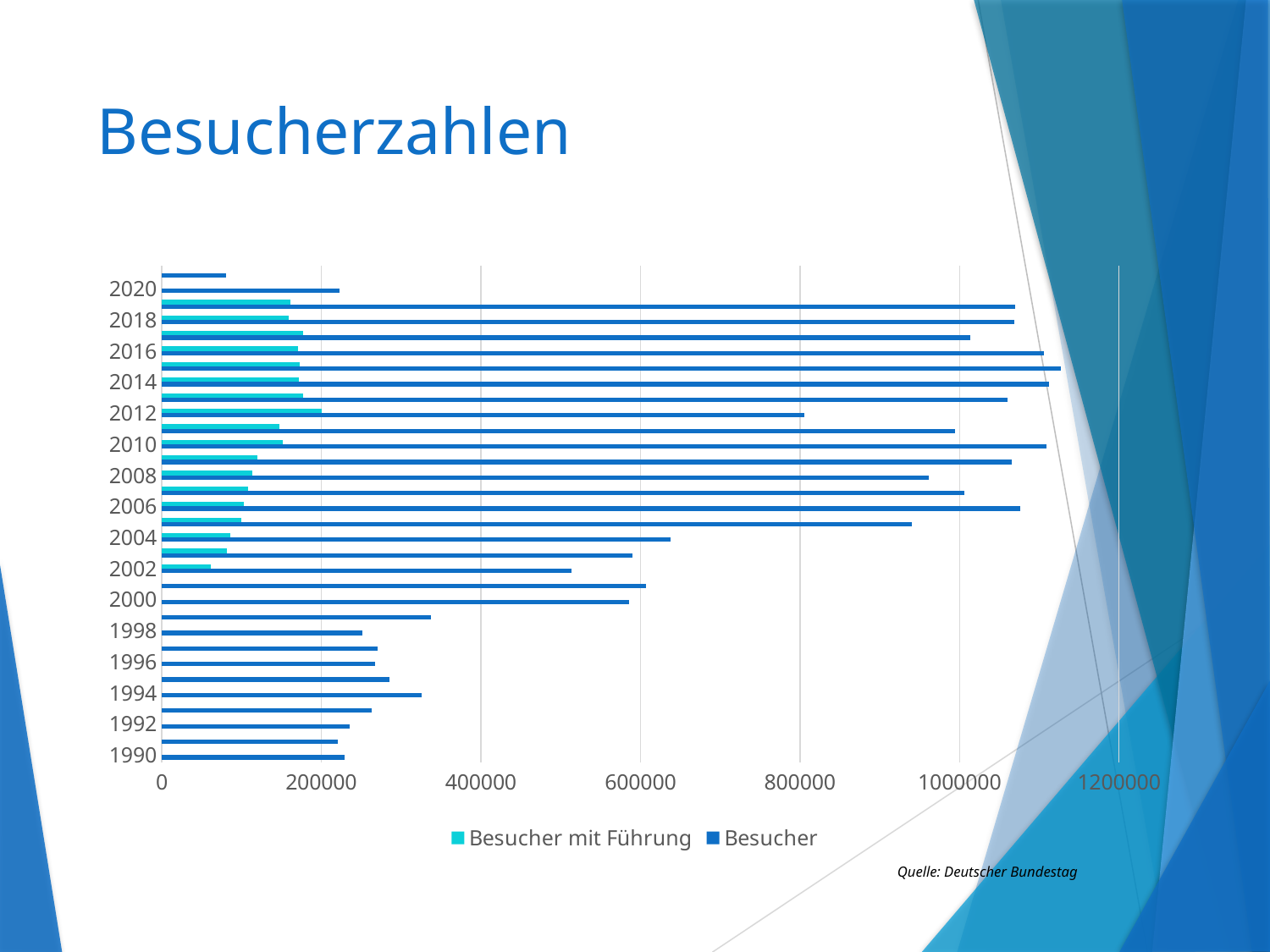
Do the Besucher values rise or fall from 2018 to 2020? fall Is the value for Besucher in 2000 greater or less than 400000? greater Is the value for Besucher in 2008 greater or less than 1000000? less How many series does the legend list? 2 What are the two series named in the legend? Besucher mit Führung, Besucher Which is larger, the Besucher value for 2016 or for 2020? 2016 What kind of chart is shown on the slide? bar chart What is the title of the chart? Besucherzahlen Is the value for Besucher in 2020 greater or less than 400000? less